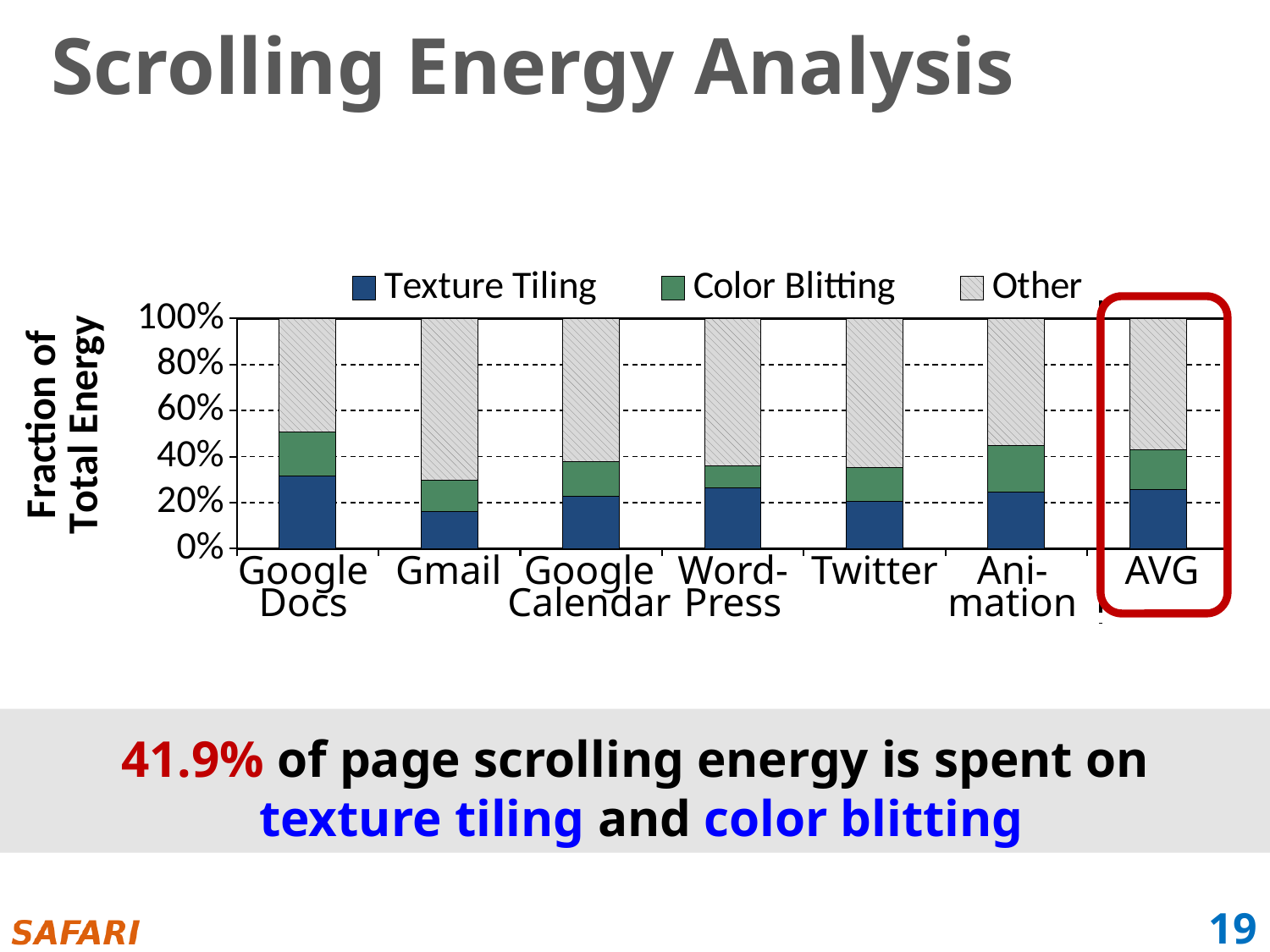
Is the combined Texture Tiling and Color Blitting share for Google Docs greater or less than 40%? greater Is the combined Texture Tiling and Color Blitting share for Gmail greater or less than 40%? less Which category has the largest Texture Tiling share? Google Docs Which has the larger Texture Tiling share, Google Docs or Gmail? Google Docs How many categories are shown along the x axis of the chart? 7 Which category on the x axis is highlighted with a red box? AVG Is the Texture Tiling value for Gmail greater or less than 20%? less Which category has the smallest Texture Tiling share? Gmail What are the three series listed in the chart's legend? Texture Tiling, Color Blitting, Other What kind of chart is shown on the slide? Stacked bar chart How many series does the chart's legend list? 3